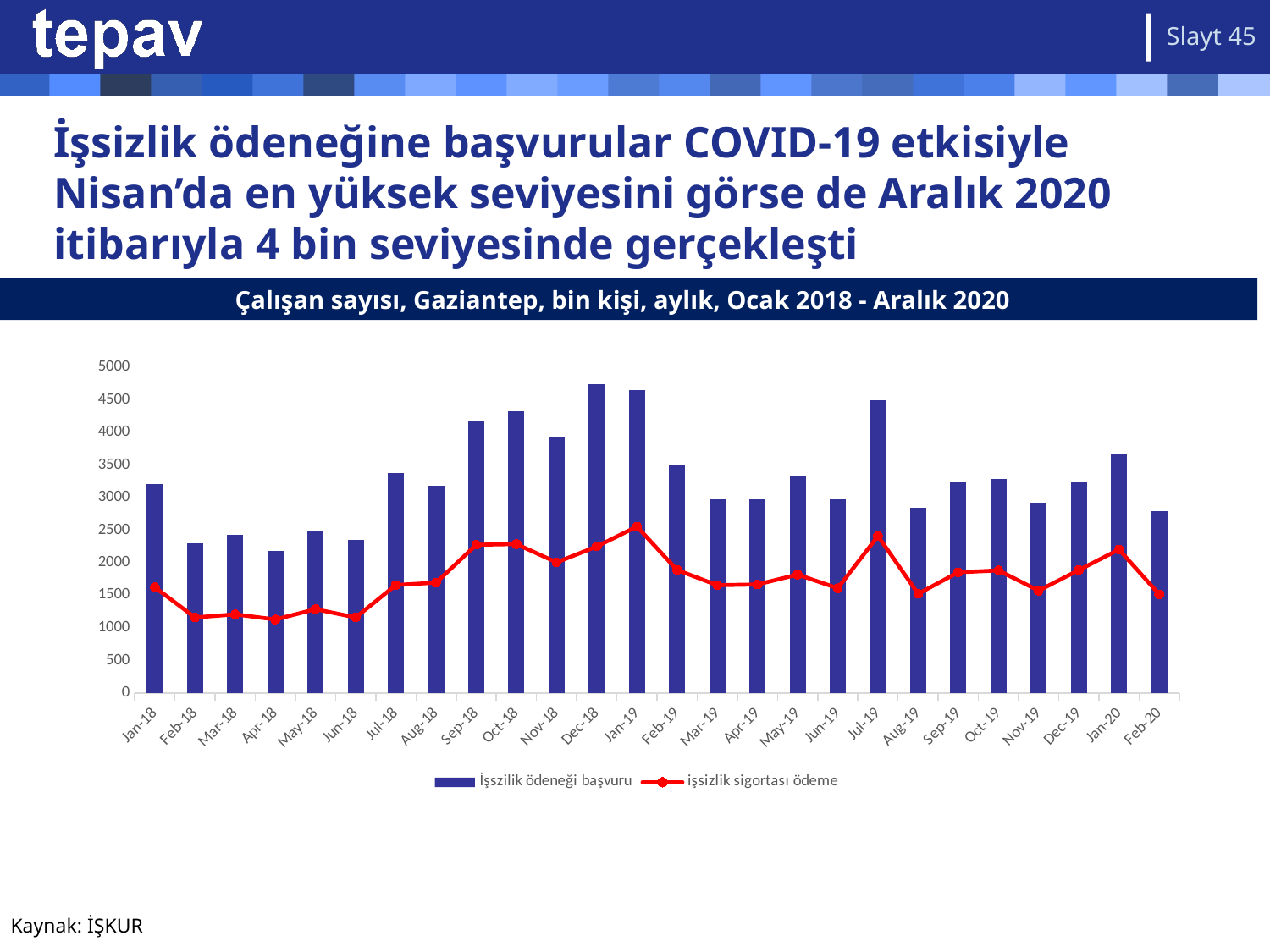
How many months are plotted along the x axis? 26 Is the İşsizlik ödeneği başvuru bar for Jul-19 greater or less than 4000? greater Do the İşsizlik ödeneği başvuru bars rise or fall from Jan-19 to Mar-19? fall Is the İşsizlik ödeneği başvuru bar for Dec-18 greater or less than 4500? greater Which series is drawn as a red line with markers? İşsizlik sigortası ödeme What kind of chart is shown on the slide? A bar chart combined with a line chart Is the İşsizlik ödeneği başvuru bar for Apr-18 greater or less than 2500? less Which series is drawn as blue bars? İşsizlik ödeneği başvuru How many series does the legend list? 2 Which is larger, the İşsizlik ödeneği başvuru bar for Jul-19 or for Aug-19? Jul-19 Which month has the highest İşsizlik sigortası ödeme value? Jan-19